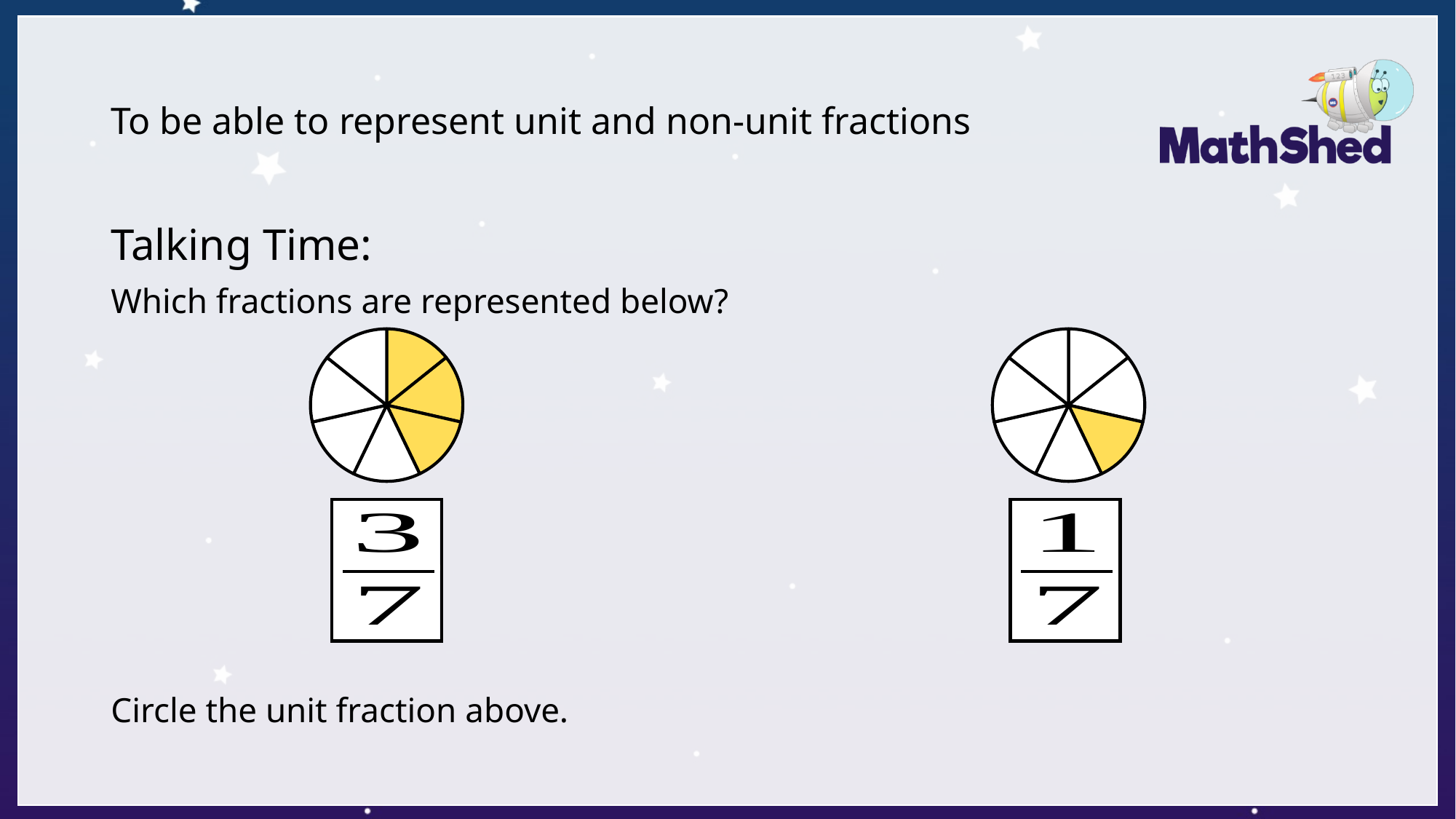
Which circle has the larger shaded share, the left or the right? left How many parts of the right circle are shaded yellow? 1 What colour are the shaded parts in both circles? yellow What kind of chart is the left diagram on the slide? pie chart What share of the left circle is shaded yellow? 3/7 How many equal parts is the right circle divided into? 7 How many more parts are shaded in the left circle than in the right circle? 2 What fraction is printed below the right circle? 1/7 How many equal parts is the left circle divided into? 7 What share of the right circle is shaded yellow? 1/7 What fraction is printed below the left circle? 3/7